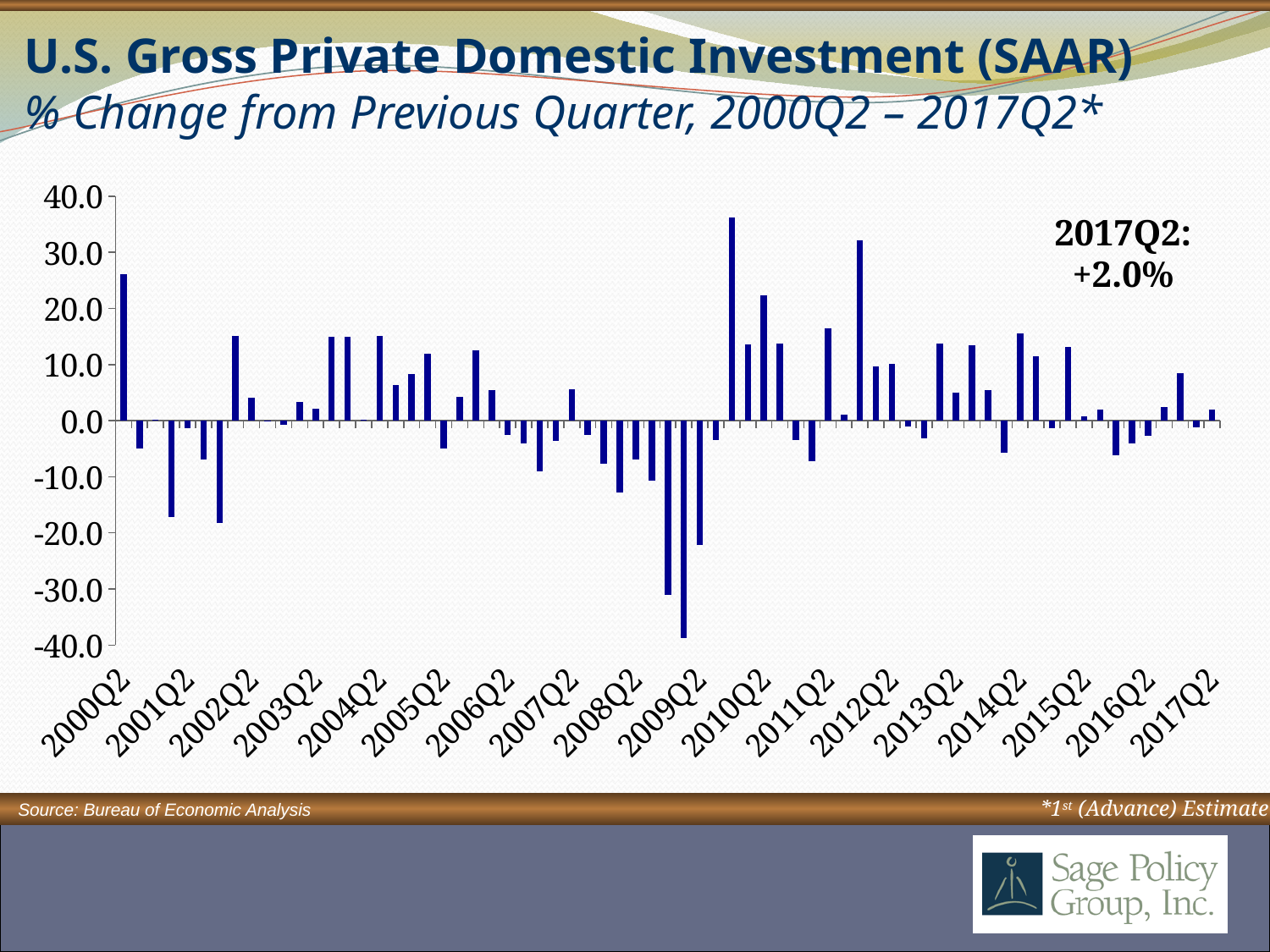
Is the value for 2000Q2 greater or less than 20.0? greater What kind of chart is shown on the slide? Bar chart Which is larger, the value for 2000Q2 or the value for 2017Q2? 2000Q2 What is the title of the chart? U.S. Gross Private Domestic Investment (SAAR) What is the value for 2017Q2? +2.0% What is the highest value shown on the y-axis? 40.0 Is the highest value on the chart greater or less than 30.0? greater Is the value for 2017Q2 greater or less than 10.0? less Is the value for 2017Q2 positive or negative? positive